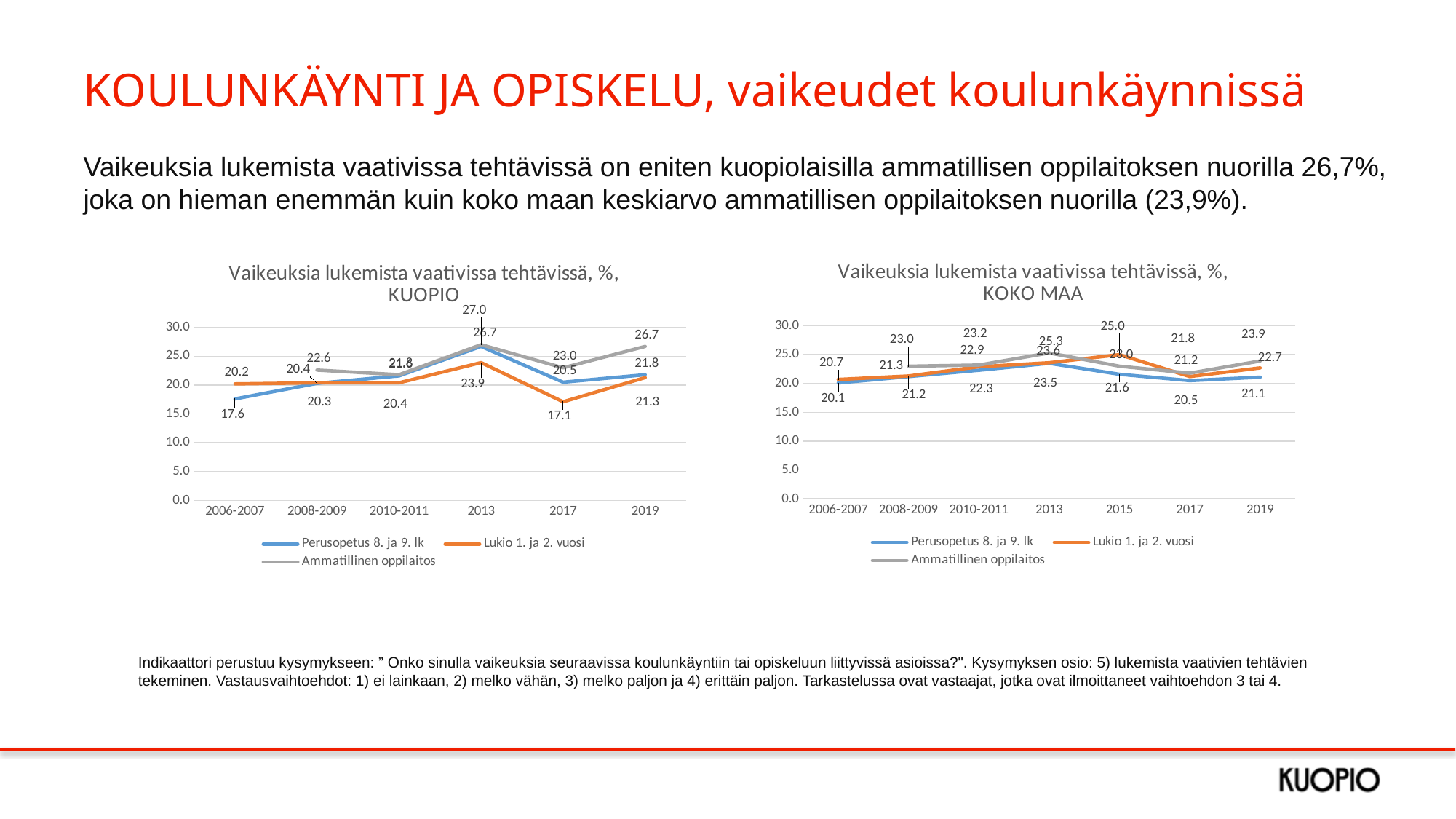
How many categories are shown on the x axis of the KOKO MAA chart? 7 In the KUOPIO chart, what is the value for Perusopetus 8. ja 9. lk in 2013? 26.7 In the KOKO MAA chart, what is the value for Lukio 1. ja 2. vuosi in 2015? 25.0 In the KUOPIO chart, which series has the higher value in 2013: Perusopetus 8. ja 9. lk or Lukio 1. ja 2. vuosi? Perusopetus 8. ja 9. lk In the KUOPIO chart, in which year is the Lukio 1. ja 2. vuosi value lowest? 2017 In the KUOPIO chart, in which year is the Lukio 1. ja 2. vuosi value highest? 2013 In the KUOPIO chart, what is the value for Ammatillinen oppilaitos in 2019? 26.7 What type of chart is the left chart titled 'Vaikeuksia lukemista vaativissa tehtävissä, %, KUOPIO'? Line chart In the KUOPIO chart, what is the difference between Ammatillinen oppilaitos and Perusopetus 8. ja 9. lk in 2019? 4.9 How many series does the legend of the KUOPIO chart list? 3 In the KUOPIO chart, what is the value for Lukio 1. ja 2. vuosi in 2017? 17.1 In the KOKO MAA chart, what is the value for Ammatillinen oppilaitos in 2019? 23.9